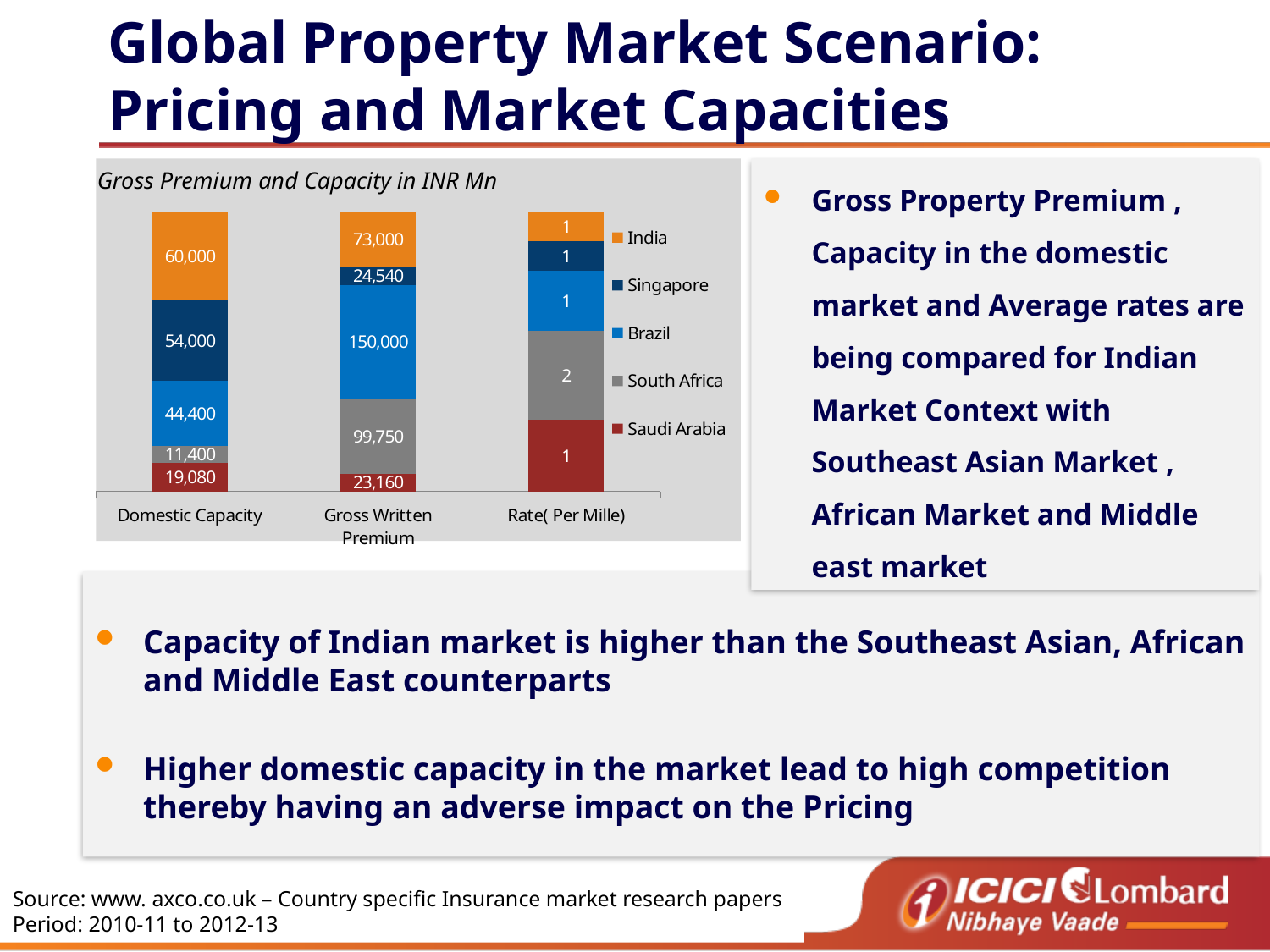
What type of chart is shown on the slide? Stacked bar chart What is the Rate (Per Mille) value for South Africa? 2 What is the difference between India's and Singapore's Domestic Capacity? 6,000 Which is larger: South Africa's Gross Written Premium or India's Gross Written Premium? South Africa's Gross Written Premium What is the Domestic Capacity value for India? 60,000 How many categories are shown on the x axis? 3 Which country has the highest Domestic Capacity? India What is the Gross Written Premium value for Saudi Arabia? 23,160 What is the Gross Written Premium value for Brazil? 150,000 Which country has the lowest Gross Written Premium? Saudi Arabia How many countries does the legend list? 5